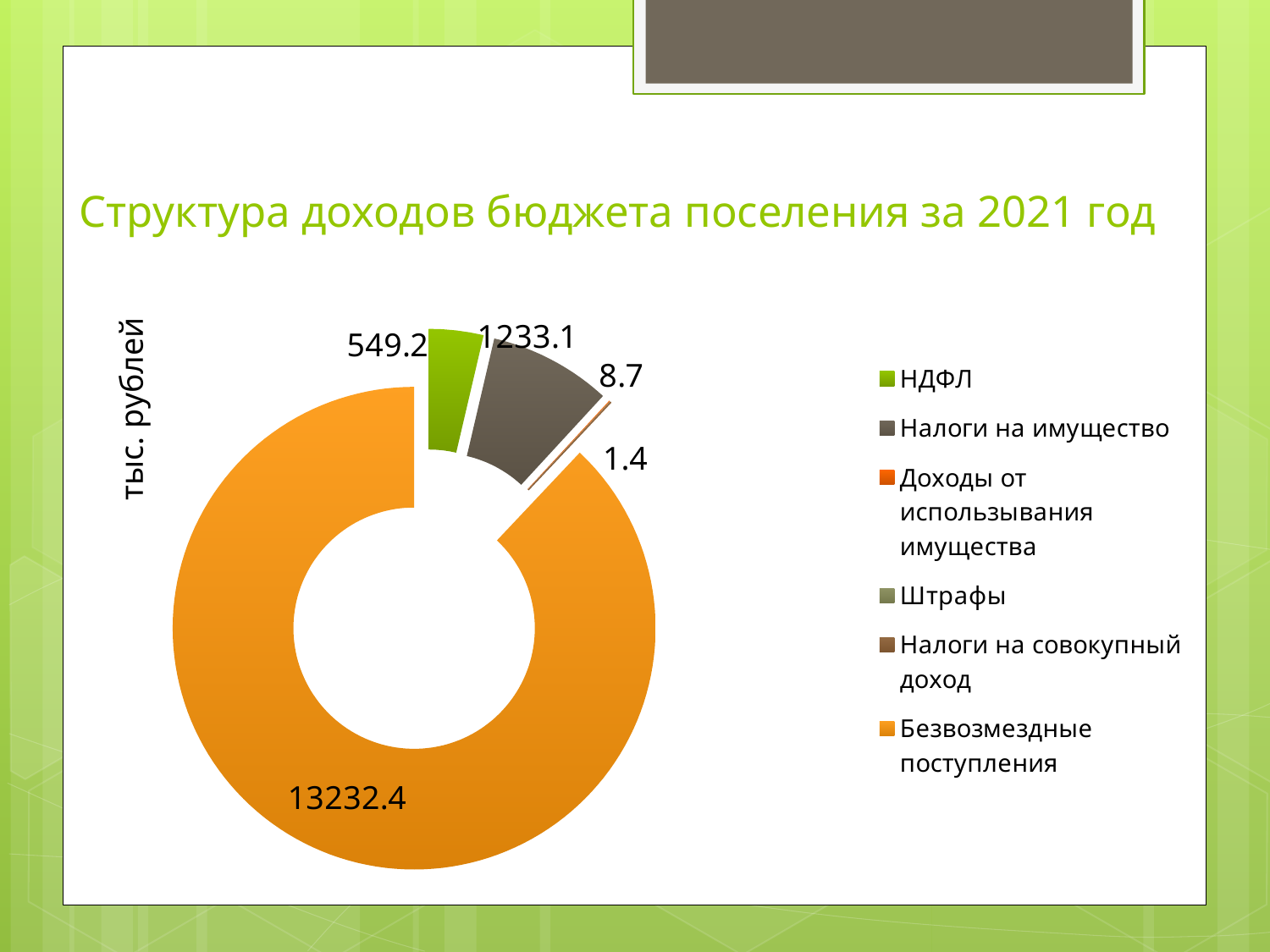
What is the value shown for Налоги на имущество? 1233.1 What is the difference between the values for Налоги на имущество and НДФЛ? 683.9 What is the title of the chart? Структура доходов бюджета поселения за 2021 год What is the smallest value labelled on the chart? 1.4 What is the value shown for Безвозмездные поступления? 13232.4 What kind of chart is shown on the slide? Doughnut (pie) chart Which is larger, the value for НДФЛ or the value for Налоги на имущество? Налоги на имущество Which category has the largest value on the chart? Безвозмездные поступления What unit is indicated by the label next to the chart? тыс. рублей How many categories does the legend list? 6 What is the value shown for НДФЛ on the chart? 549.2